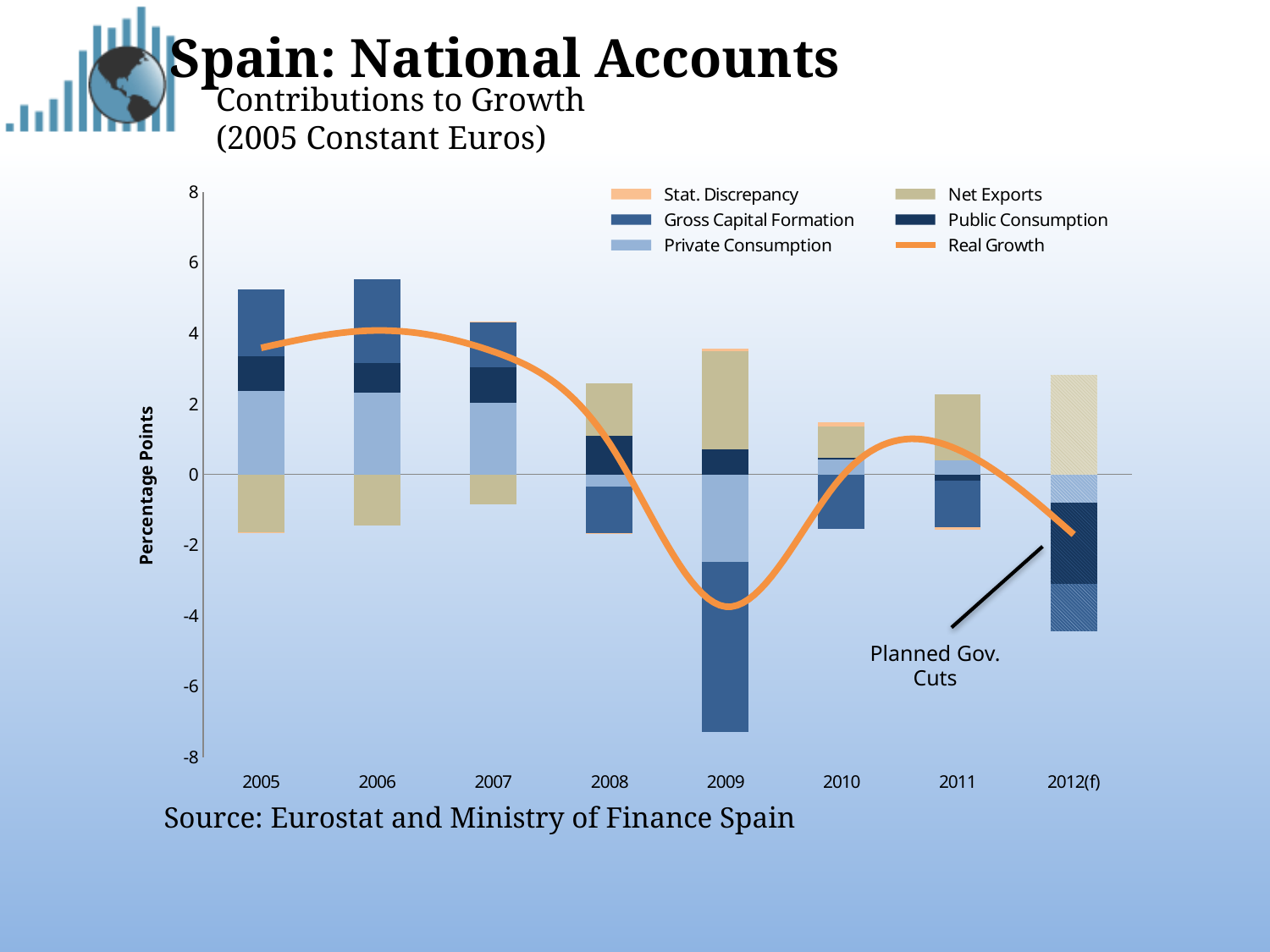
What kind of chart is shown on the slide? Stacked bar chart with a line In which year does the Real Growth line reach its highest point? 2006 Does the Real Growth line rise or fall from 2006 to 2009? fall Is the Real Growth value for 2012(f) greater or less than 0? less Which year's bar does the 'Planned Gov. Cuts' annotation point to? 2012(f) Is the Real Growth value for 2009 greater or less than -2? less What is the label on the vertical axis of the chart? Percentage Points Is the Real Growth value for 2005 greater or less than 2? greater How many series does the chart's legend list? 6 How many years are shown on the x axis of the chart? 8 Which year has the larger Real Growth value, 2005 or 2009? 2005 In which year does the Real Growth line reach its lowest point? 2009